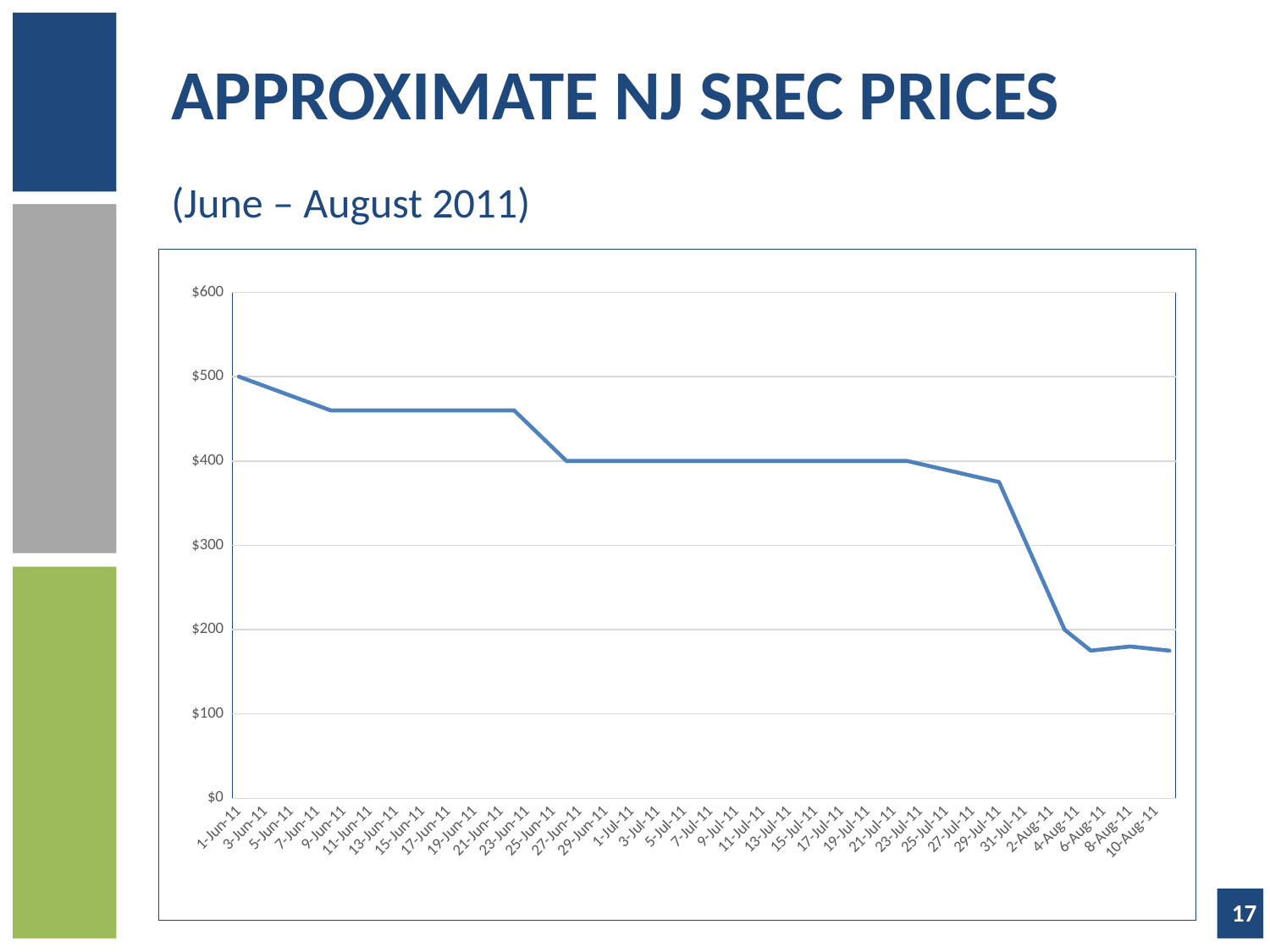
What is the value on 1-Jun-11? $500 On which date is the value highest? 1-Jun-11 Do the values generally rise or fall from June to August 2011? fall Is the value on 10-Aug-11 greater or less than $200? less Is the value on 9-Jun-11 greater or less than $400? greater What is the value on 1-Jul-11? $400 What is the value on 15-Jul-11? $400 Is the value on 15-Jun-11 greater or less than $500? less What is the title of the chart on the slide? APPROXIMATE NJ SREC PRICES What kind of chart is shown on the slide? line chart Which is larger, the value on 1-Jun-11 or the value on 10-Aug-11? 1-Jun-11 What period does the chart cover, according to the subtitle? June – August 2011